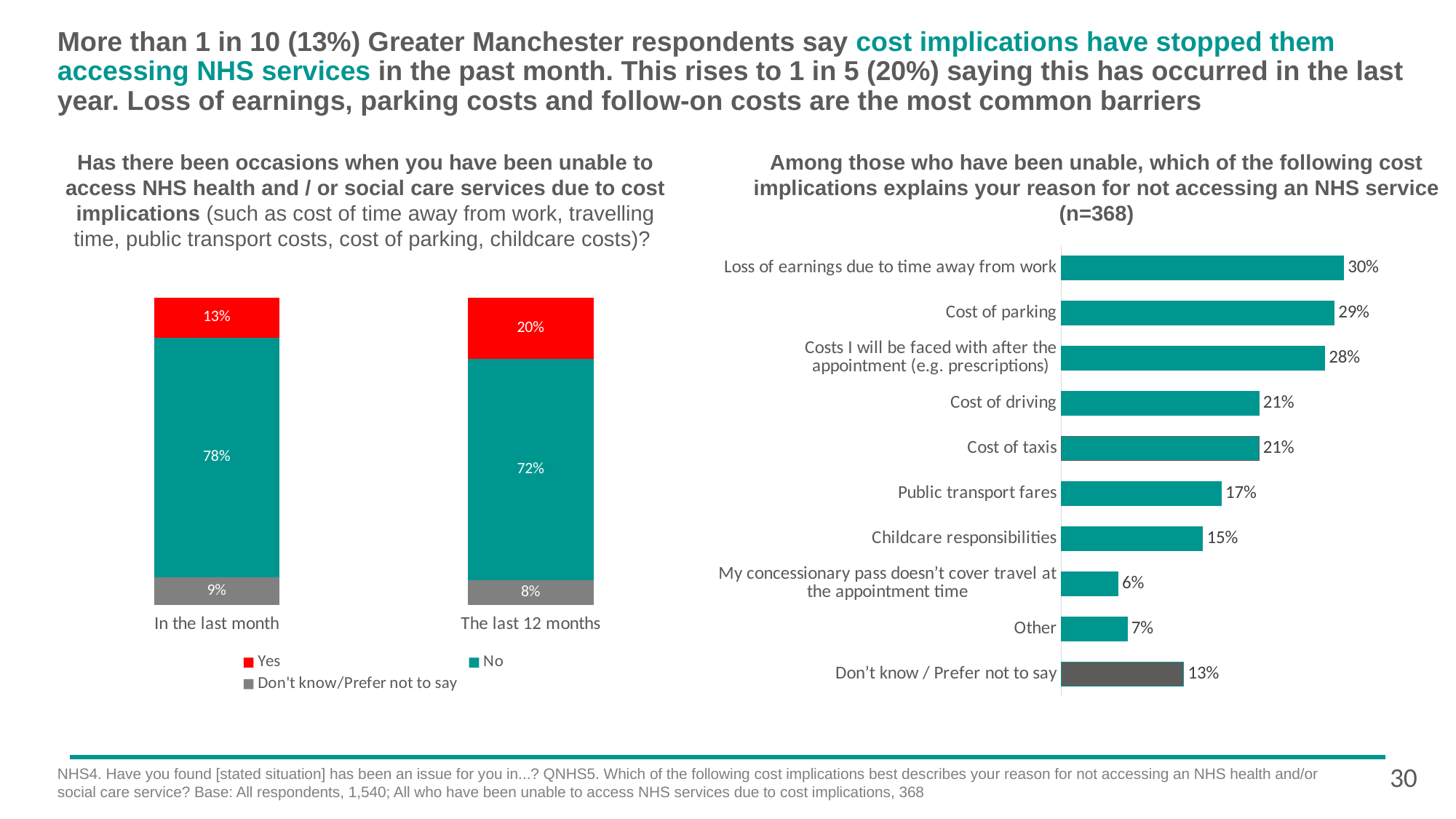
In the right chart (cost implications for not accessing an NHS service), which cost implication has the highest percentage? Loss of earnings due to time away from work What kind of chart is the right chart (cost implications for not accessing an NHS service)? Bar chart In the left chart (unable to access NHS services due to cost implications), how many series does the legend list? 3 In the right chart (cost implications for not accessing an NHS service), what percentage is shown for 'Cost of parking'? 29% In the left chart (unable to access NHS services due to cost implications), what percentage answered No for 'The last 12 months'? 72% In the right chart (cost implications for not accessing an NHS service), which is larger: 'Public transport fares' or 'Other'? Public transport fares In the left chart (unable to access NHS services due to cost implications), what is the difference between the Yes share for 'The last 12 months' and for 'In the last month'? 7 percentage points In the left chart (unable to access NHS services due to cost implications), what percentage answered Yes for 'In the last month'? 13% In the right chart (cost implications for not accessing an NHS service), which category has the lowest percentage? My concessionary pass doesn't cover travel at the appointment time In the right chart (cost implications for not accessing an NHS service), how many categories are plotted? 10 In the right chart (cost implications for not accessing an NHS service), what percentage is shown for 'Childcare responsibilities'? 15% In the left chart (unable to access NHS services due to cost implications), what is the total of the stacked bar for 'In the last month'? 100%